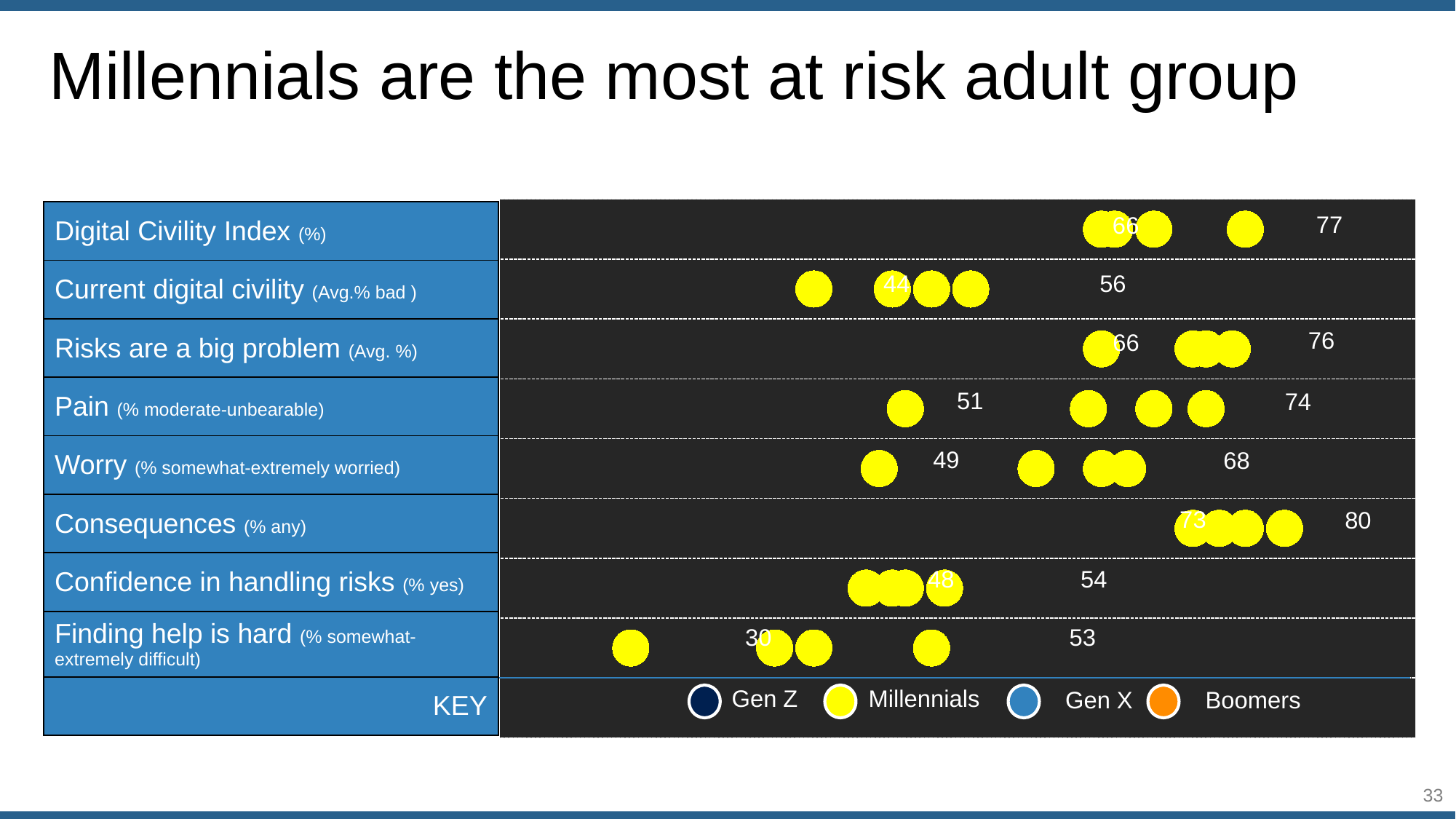
What is the difference between the two values printed in the Pain row, 74 and 51? 23 What is the difference between the two values printed in the Worry row, 68 and 49? 19 How many groups does the key at the bottom of the chart list? 4 Which row has the highest printed value on the chart? Consequences (% any) What is the title of the slide containing the chart? Millennials are the most at risk adult group Which groups are listed in the chart's key? Gen Z, Millennials, Gen X, Boomers Which is larger: the highest value printed in the Digital Civility Index row or the highest value printed in the Risks are a big problem row? Digital Civility Index (77) How many metric rows (categories) does the chart show? 8 Which row has the lowest printed value on the chart? Finding help is hard What is the highest value printed in the Consequences (% any) row? 80 What is the lowest value printed in the Finding help is hard row? 30 What two values are printed in the Pain (% moderate-unbearable) row? 51 and 74